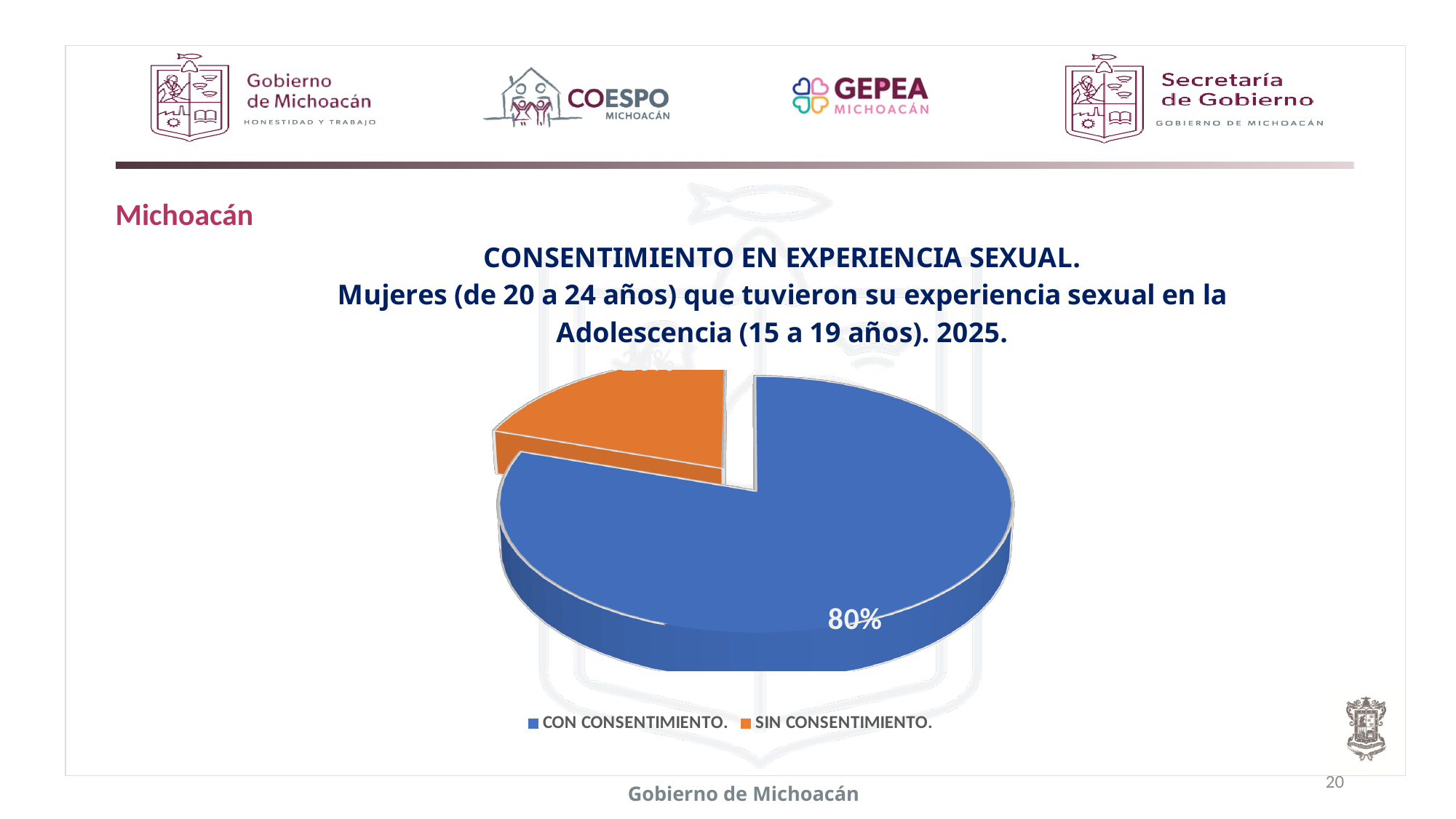
How many slices does the pie chart have? 2 Which is larger, the share for CON CONSENTIMIENTO or the share for SIN CONSENTIMIENTO? CON CONSENTIMIENTO. Is the share for CON CONSENTIMIENTO greater or less than 50%? greater Is the share for SIN CONSENTIMIENTO greater or less than 50%? less What kind of chart is shown on the slide? Pie chart Which category has the largest share of the pie? CON CONSENTIMIENTO. What colour is the slice for SIN CONSENTIMIENTO? Orange Which category has the smallest share of the pie? SIN CONSENTIMIENTO. What percentage of the pie corresponds to CON CONSENTIMIENTO? 80% How many entries does the legend list? 2 What year is stated in the chart title? 2025